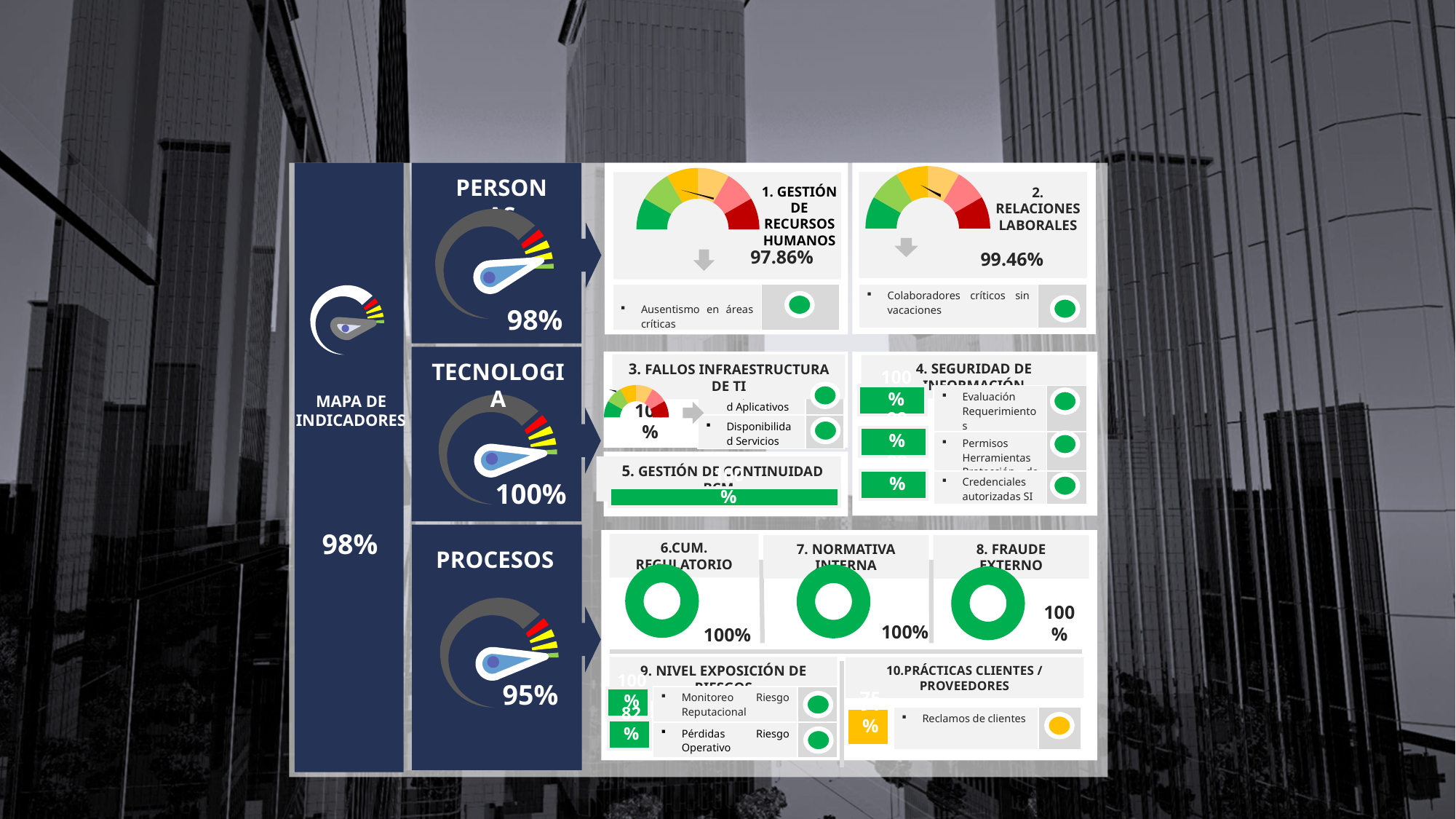
What value is shown on the 'TECNOLOGIA' gauge in the left column? 100% What colour is the status indicator next to 'Reclamos de clientes' in the '10. PRÁCTICAS CLIENTES / PROVEEDORES' box? Yellow What value is shown on the 'PROCESOS' gauge in the left column? 95% What is the difference between the '2. Relaciones Laborales' value and the '1. Gestión de Recursos Humanos' value? 1.60% What value is shown on the 'PERSONAS' gauge in the left column? 98% Among the PERSONAS, TECNOLOGIA and PROCESOS gauges, which has the lowest value? PROCESOS Which has the higher value, the '1. Gestión de Recursos Humanos' gauge or the '2. Relaciones Laborales' gauge? 2. Relaciones Laborales What overall value is shown under 'MAPA DE INDICADORES' in the leftmost column? 98% On the gauge for '1. Gestión de Recursos Humanos', what value is shown? 97.86% What value is shown next to the '6. CUM. REGULATORIO' donut chart? 100% What kind of chart is used for '8. FRAUDE EXTERNO'? Donut chart On the gauge for '2. Relaciones Laborales', what value is shown? 99.46%